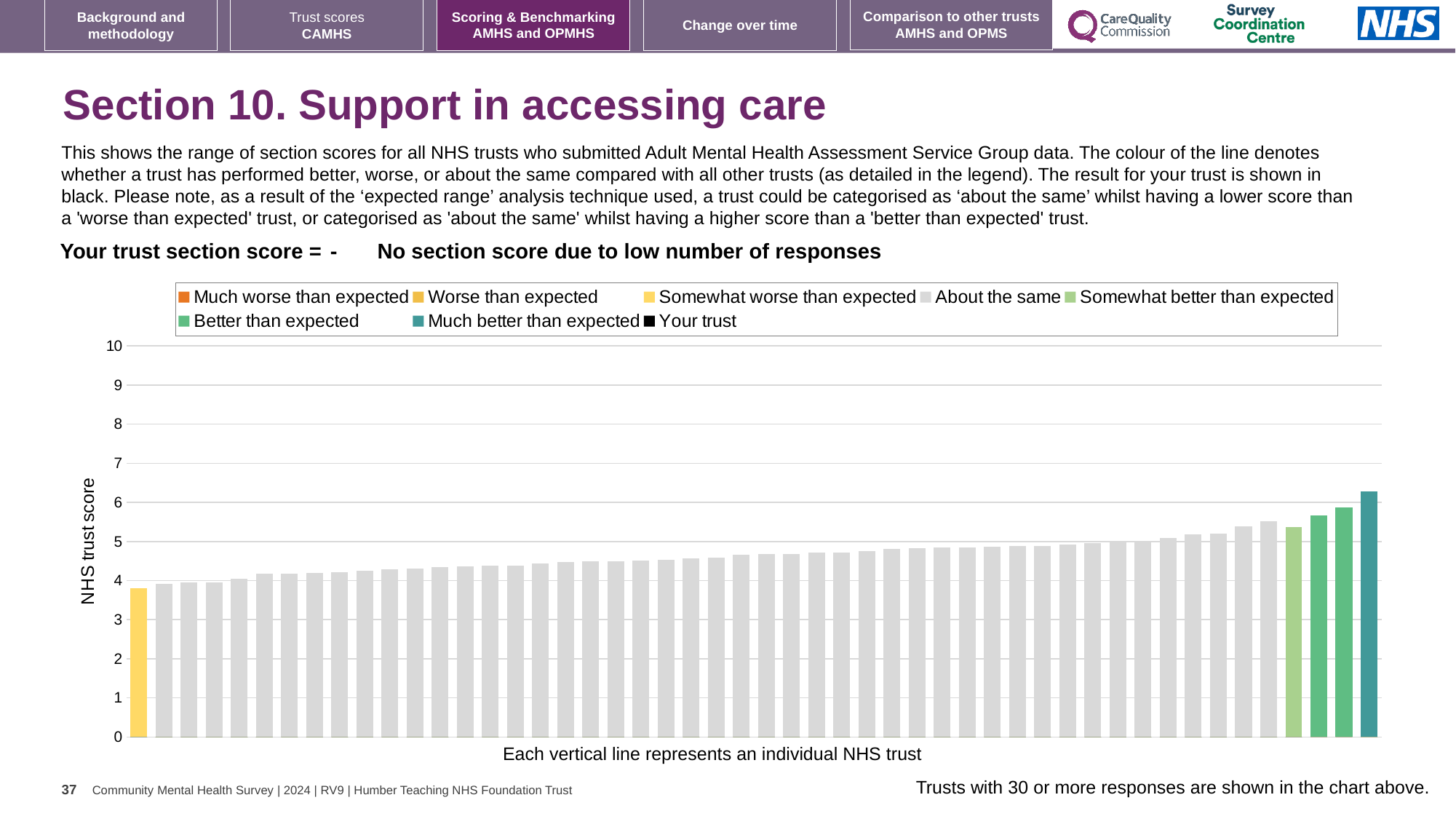
Is the value of the tallest bar (the rightmost, teal bar) greater or less than 6? greater Which is larger: the value of the leftmost bar or the value of the rightmost bar? The rightmost bar Do the bar values rise or fall from left to right along the x axis? Rise Is the value of the leftmost bar greater or less than 3? greater Which legend category does the tallest bar in the chart belong to? Much better than expected Which legend category does the shortest bar in the chart belong to? Somewhat worse than expected What colour does the legend use for 'Your trust'? Black Is the value of the tallest bar greater or less than 7? less What is the title of the vertical axis? NHS trust score How many entries does the chart legend list? 8 What kind of chart is shown on the slide? Bar chart